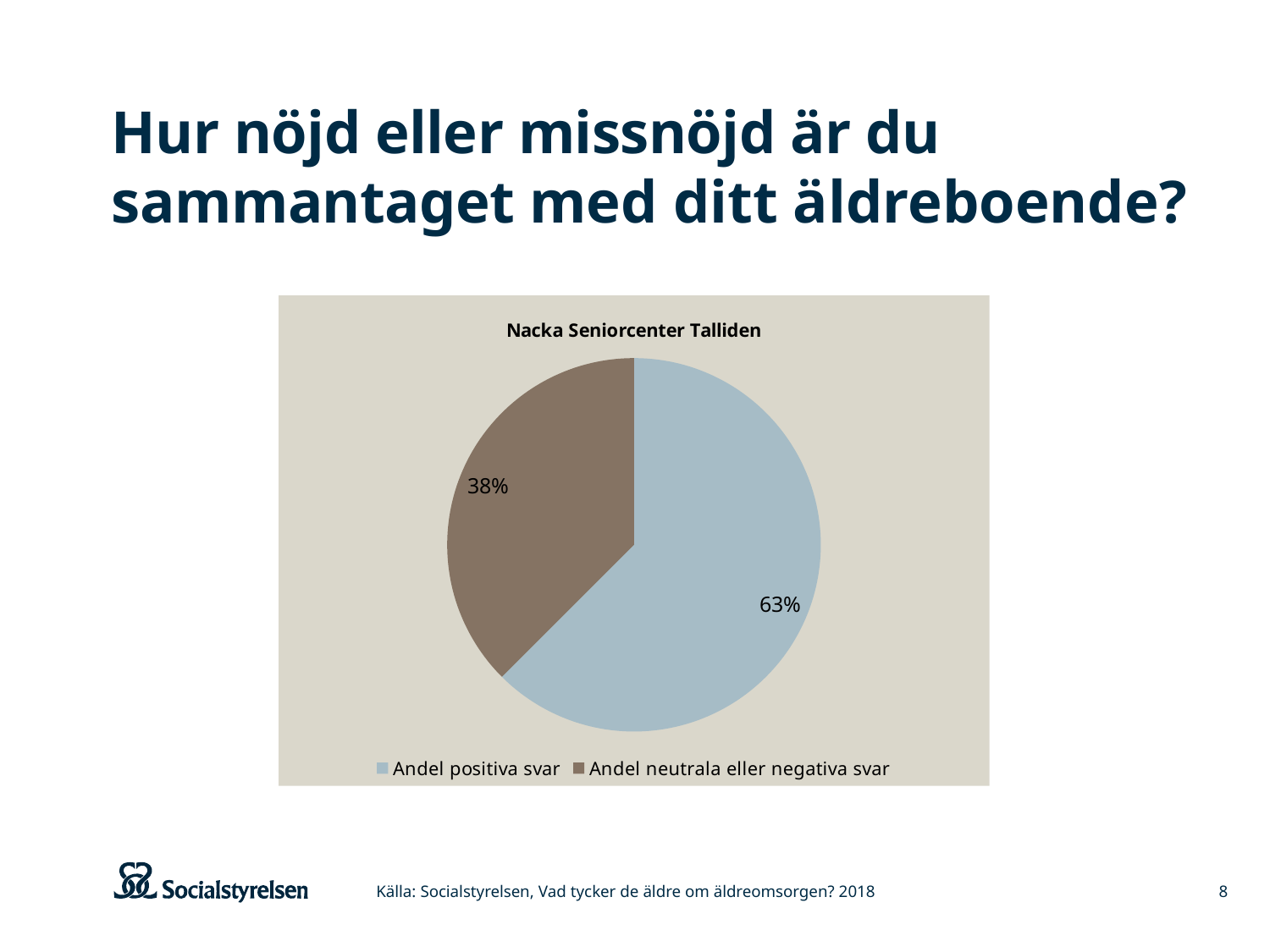
What type of chart is shown on the slide? pie chart Which slice is the largest? Andel positiva svar What is the value for Andel positiva svar? 63% How many slices does the pie chart have? 2 How many entries does the legend list? 2 What share of the pie does Andel positiva svar represent? 63% Which slice is the smallest? Andel neutrala eller negativa svar What is the value for Andel neutrala eller negativa svar? 38% Which is larger, Andel positiva svar or Andel neutrala eller negativa svar? Andel positiva svar What is the difference between Andel positiva svar and Andel neutrala eller negativa svar? 25% What colour is the slice for Andel neutrala eller negativa svar? brown What is the title of the chart? Nacka Seniorcenter Talliden